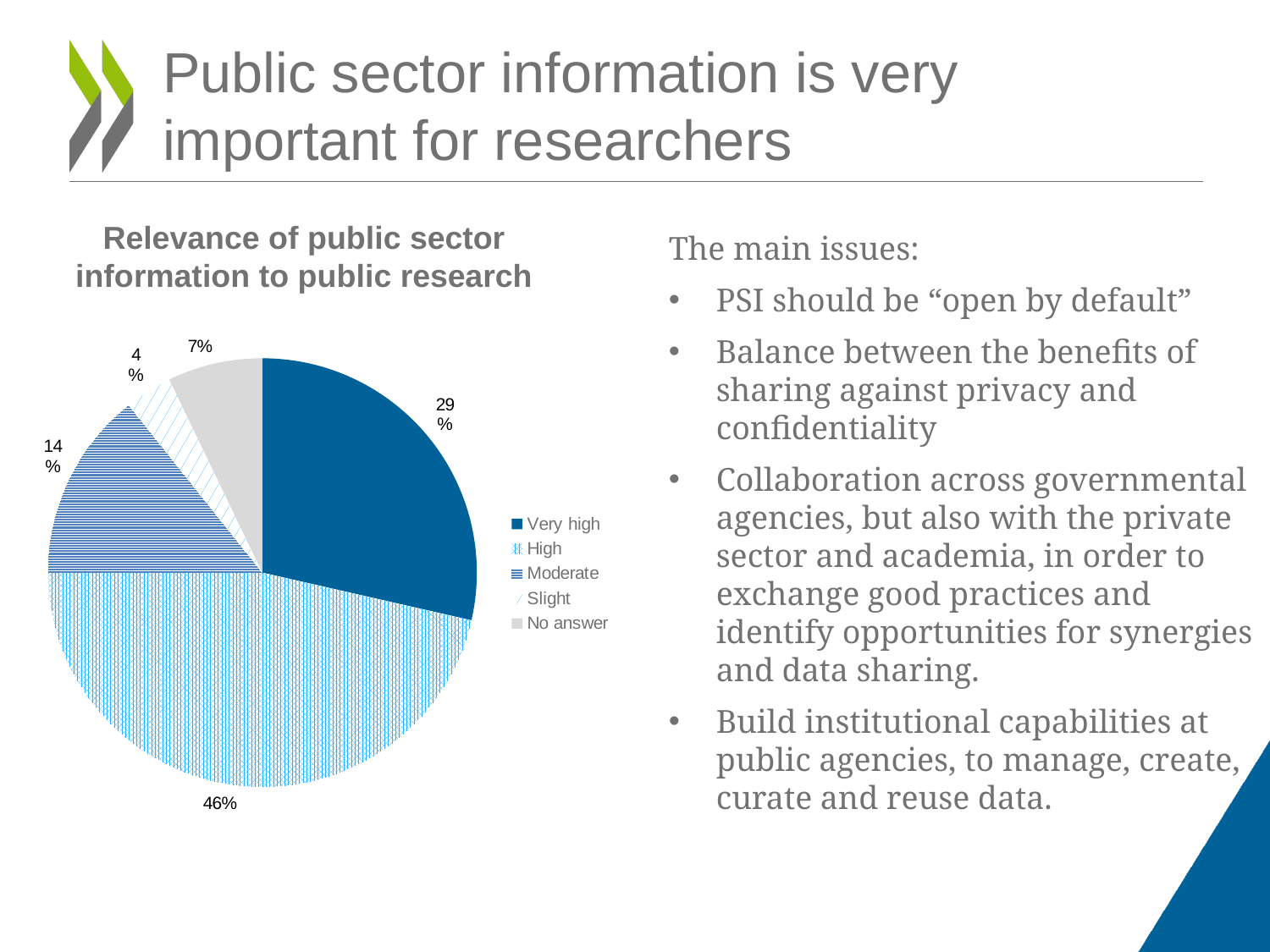
Which category has the largest slice of the pie? High What is the difference in percentage points between the "High" and "Very high" slices? 17 What is the value shown for "Moderate"? 14% What share of the pie does the "High" slice represent? 46% What kind of chart is shown on the slide? Pie chart Which is larger, the "Moderate" slice or the "No answer" slice? Moderate What is the title of the chart? Relevance of public sector information to public research How many categories does the legend list? 5 What share of the pie does the "Very high" slice represent? 29% What is the value shown for "No answer"? 7% Which category has the smallest slice of the pie? Slight What is the value shown for "Slight"? 4%